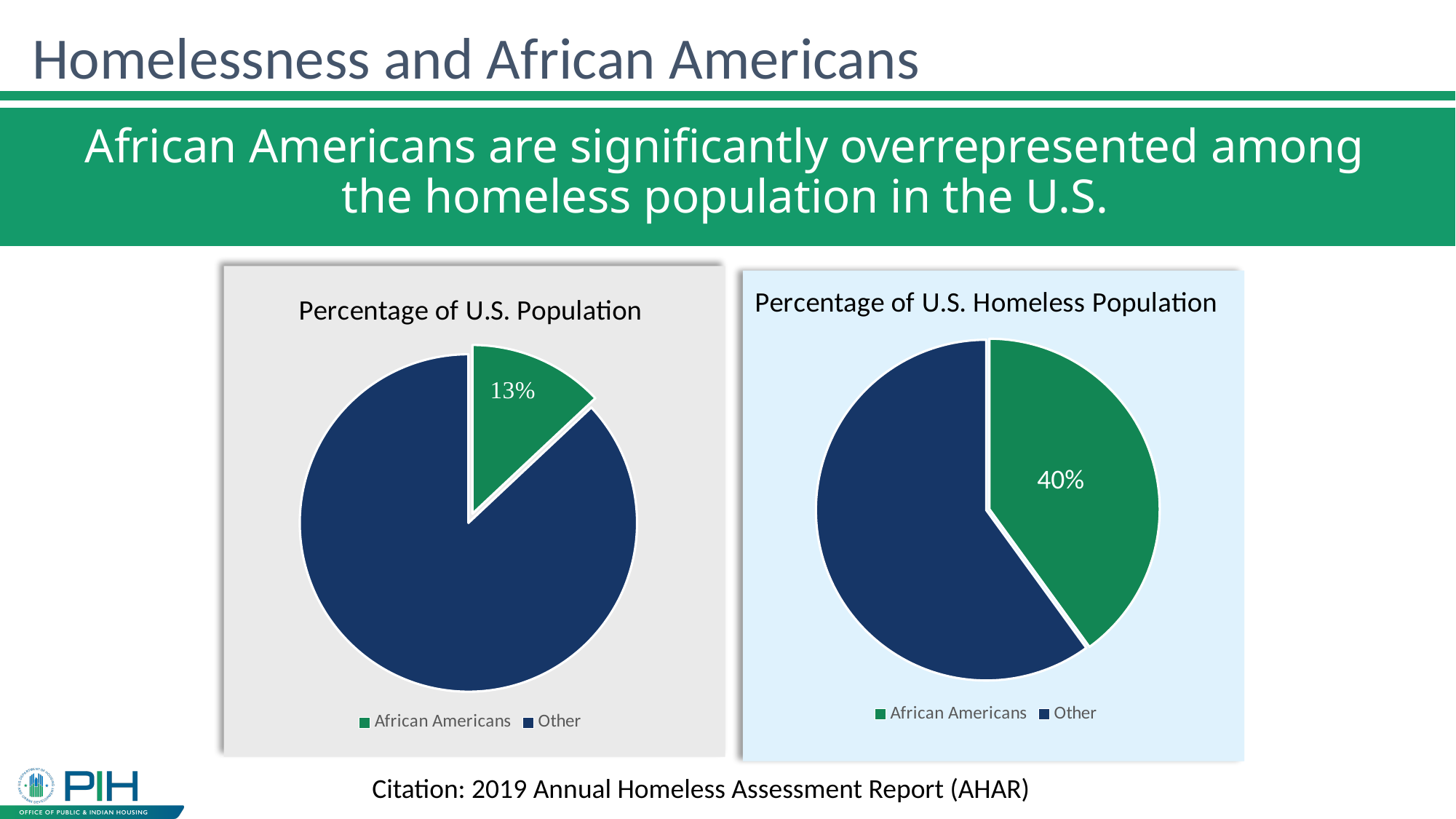
In the 'Percentage of U.S. Population' chart, what colour is the African Americans slice? Green In the 'Percentage of U.S. Homeless Population' chart, which slice is the smallest? African Americans In the 'Percentage of U.S. Homeless Population' chart, what percentage is shown for African Americans? 40% How many entries does the legend of the 'Percentage of U.S. Population' chart list? 2 In the 'Percentage of U.S. Population' chart, which slice is the largest? Other Is the African Americans share larger in the 'Percentage of U.S. Population' chart or in the 'Percentage of U.S. Homeless Population' chart? Percentage of U.S. Homeless Population What kind of chart is the 'Percentage of U.S. Homeless Population' chart? Pie chart In the 'Percentage of U.S. Homeless Population' chart, what share of the pie does the African Americans slice represent? 40% What kind of chart is the 'Percentage of U.S. Population' chart? Pie chart In the 'Percentage of U.S. Population' chart, what percentage is shown for African Americans? 13% How many percentage points higher is the African Americans share in the 'Percentage of U.S. Homeless Population' chart than in the 'Percentage of U.S. Population' chart? 27 percentage points How many slices does the 'Percentage of U.S. Homeless Population' pie chart have? 2